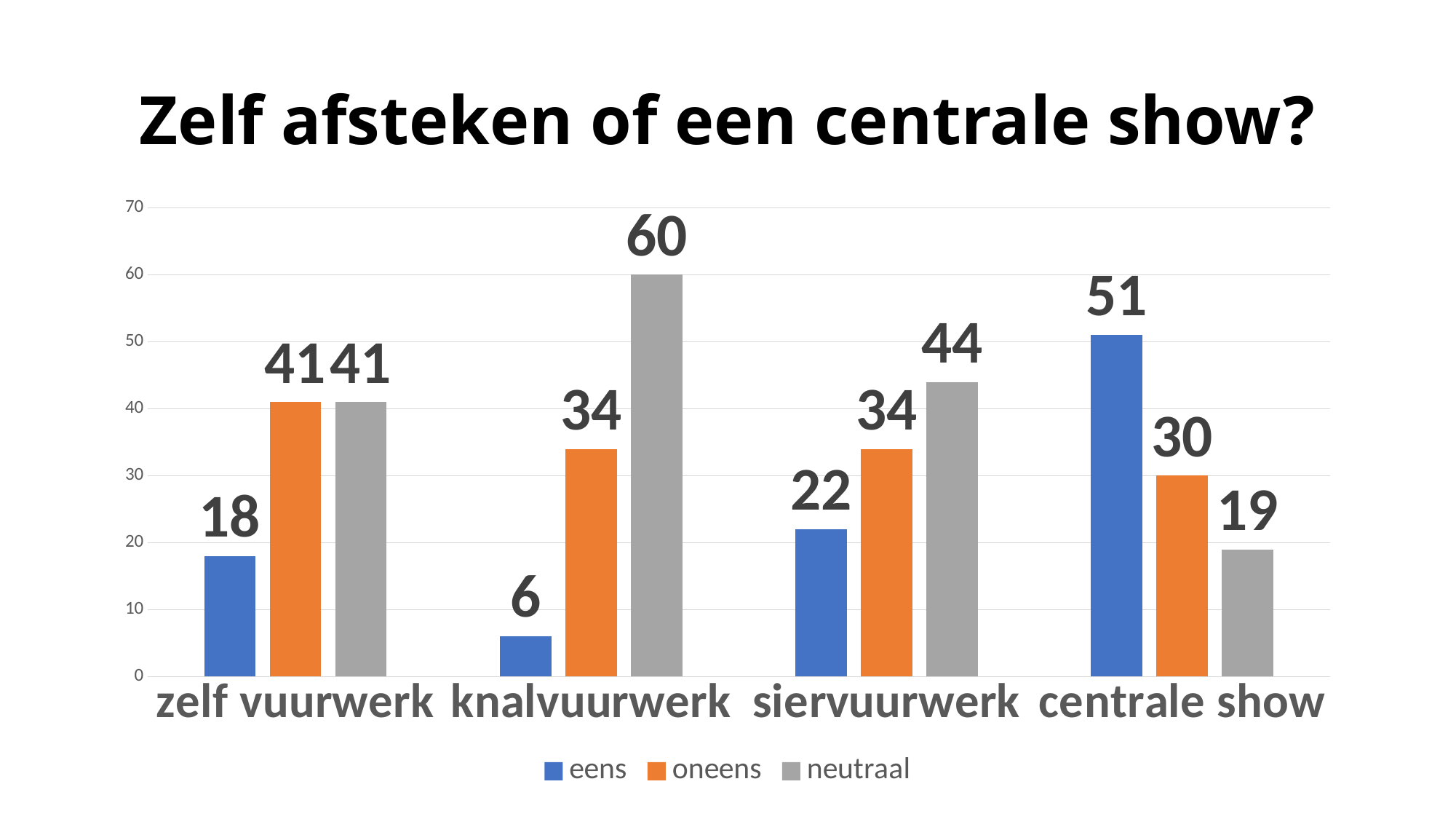
What is the value for 'neutraal' in the 'knalvuurwerk' category? 60 Which is larger: the 'eens' value for 'siervuurwerk' or the 'eens' value for 'centrale show'? centrale show Which category has the highest 'eens' value? centrale show What is the value for 'eens' in the 'zelf vuurwerk' category? 18 What is the title of the slide? Zelf afsteken of een centrale show? Which category has the lowest 'eens' value? knalvuurwerk What is the value for 'oneens' in the 'centrale show' category? 30 How many series does the legend list? 3 How many categories are shown on the x axis? 4 What kind of chart is shown on the slide? bar chart Which colour represents the 'oneens' series? orange What is the difference between the 'neutraal' value for 'knalvuurwerk' and the 'neutraal' value for 'centrale show'? 41